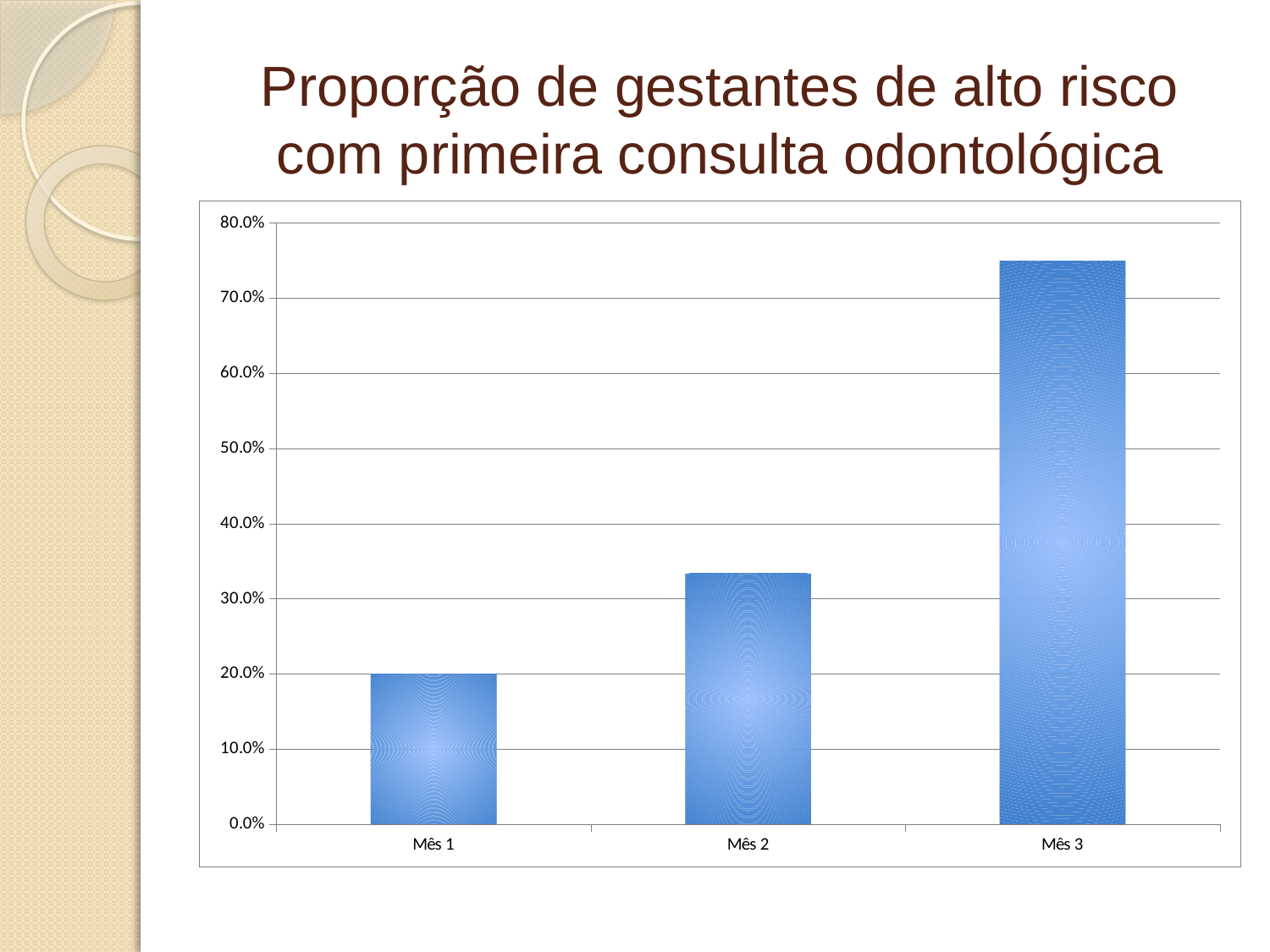
Is the value for Mês 2 greater or less than 30.0%? greater Which month has the lowest value? Mês 1 What type of chart is shown on the slide? bar chart What is the value for Mês 1? 20.0% How many categories are shown on the x axis of the chart? 3 Which is larger, the value for Mês 2 or the value for Mês 3? Mês 3 Do the values rise or fall from Mês 1 to Mês 3? rise Is the value for Mês 2 greater or less than 40.0%? less What is the title of the slide containing the chart? Proporção de gestantes de alto risco com primeira consulta odontológica Is the value for Mês 3 greater or less than 80.0%? less Which month has the highest value? Mês 3